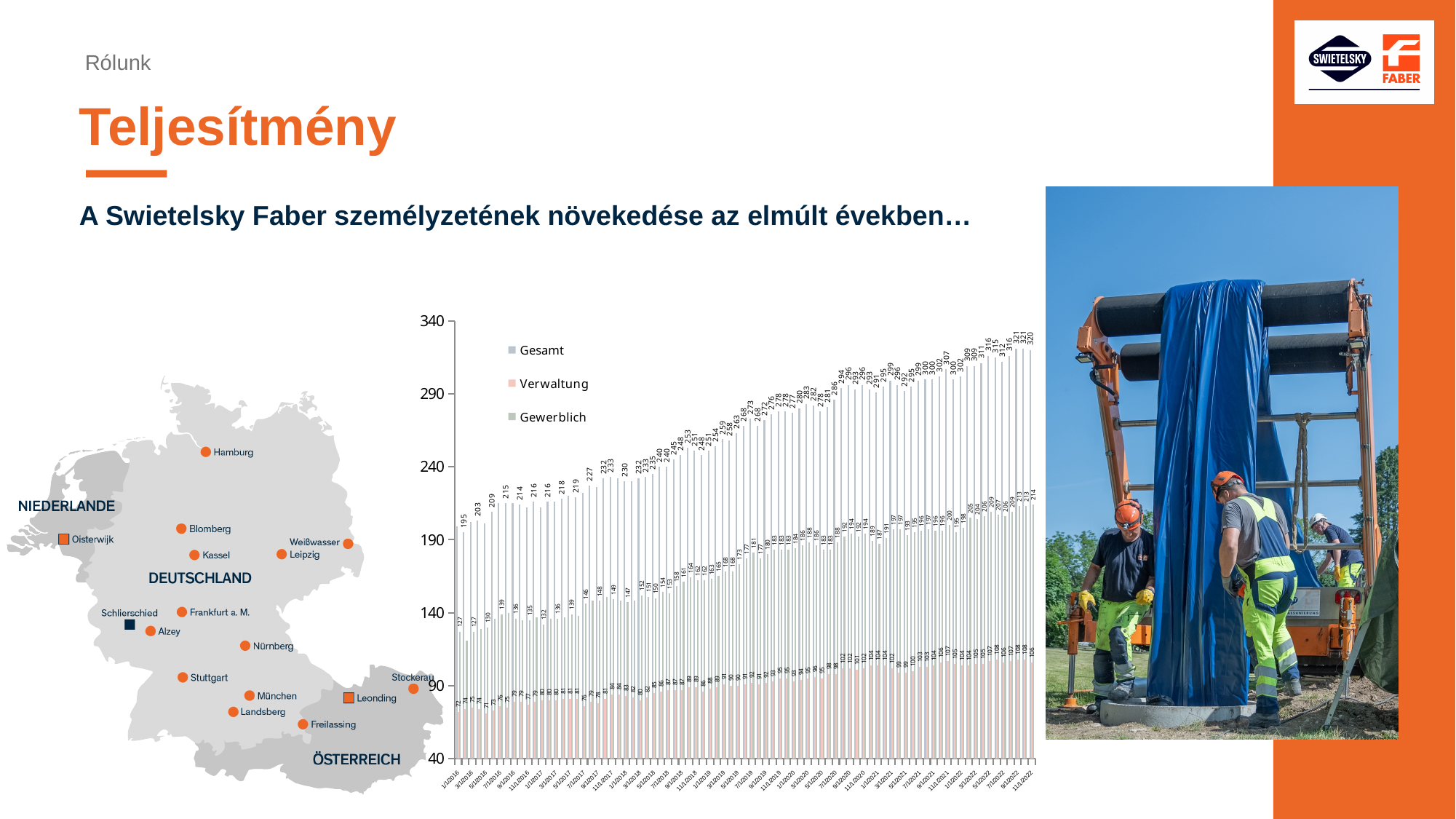
Does the Gesamt series rise or fall from 1/1/2016 to 11/1/2022? rise What are the three series named in the chart legend? Gesamt, Verwaltung, Gewerblich What kind of chart is shown on the slide? bar chart What is the Verwaltung value for 11/1/2022? 106 Is the Gesamt value for 11/1/2022 greater or less than 290? greater At 11/1/2022, which is larger: Gewerblich or Verwaltung? Gewerblich What is the Gewerblich value for 11/1/2022? 214 What is the Gewerblich value for 1/1/2016? 127 What is the Gesamt value for 11/1/2022, the last point on the chart? 320 How many series does the chart legend list? 3